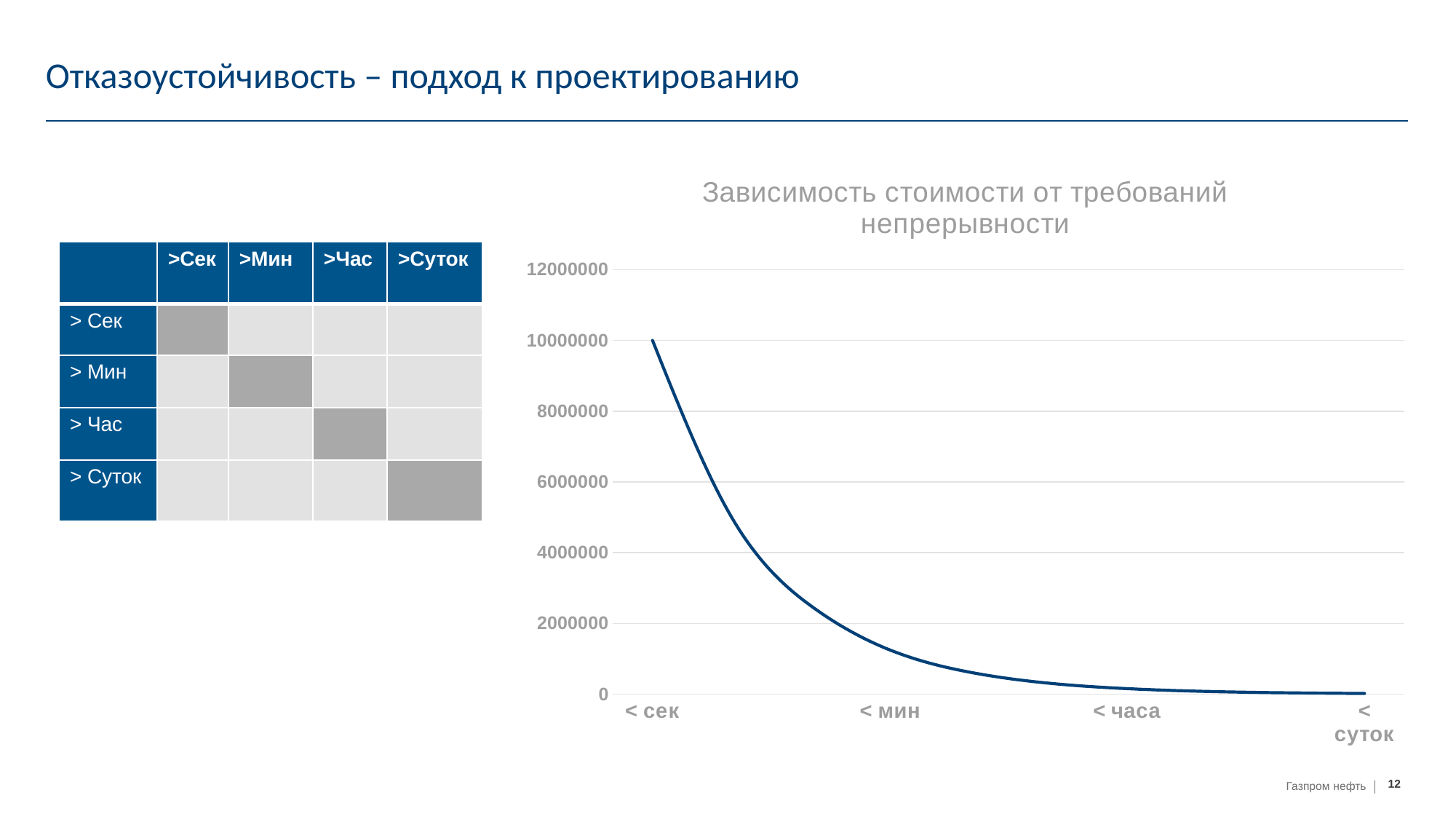
Is the value for '< суток' greater or less than 2000000? less What kind of chart is shown on the slide? Line chart Is the value for '< мин' greater or less than 4000000? less Which category has the highest value on the chart? < сек What is the highest value shown on the y axis of the chart? 12000000 Is the value for '< сек' greater or less than 8000000? greater What is the title of the chart? Зависимость стоимости от требований непрерывности Which is larger, the value for '< мин' or the value for '< часа'? < мин Which is larger, the value for '< сек' or the value for '< мин'? < сек Do the values rise or fall along the x axis from '< сек' to '< суток'? Fall How many categories are shown on the x axis of the chart? 4